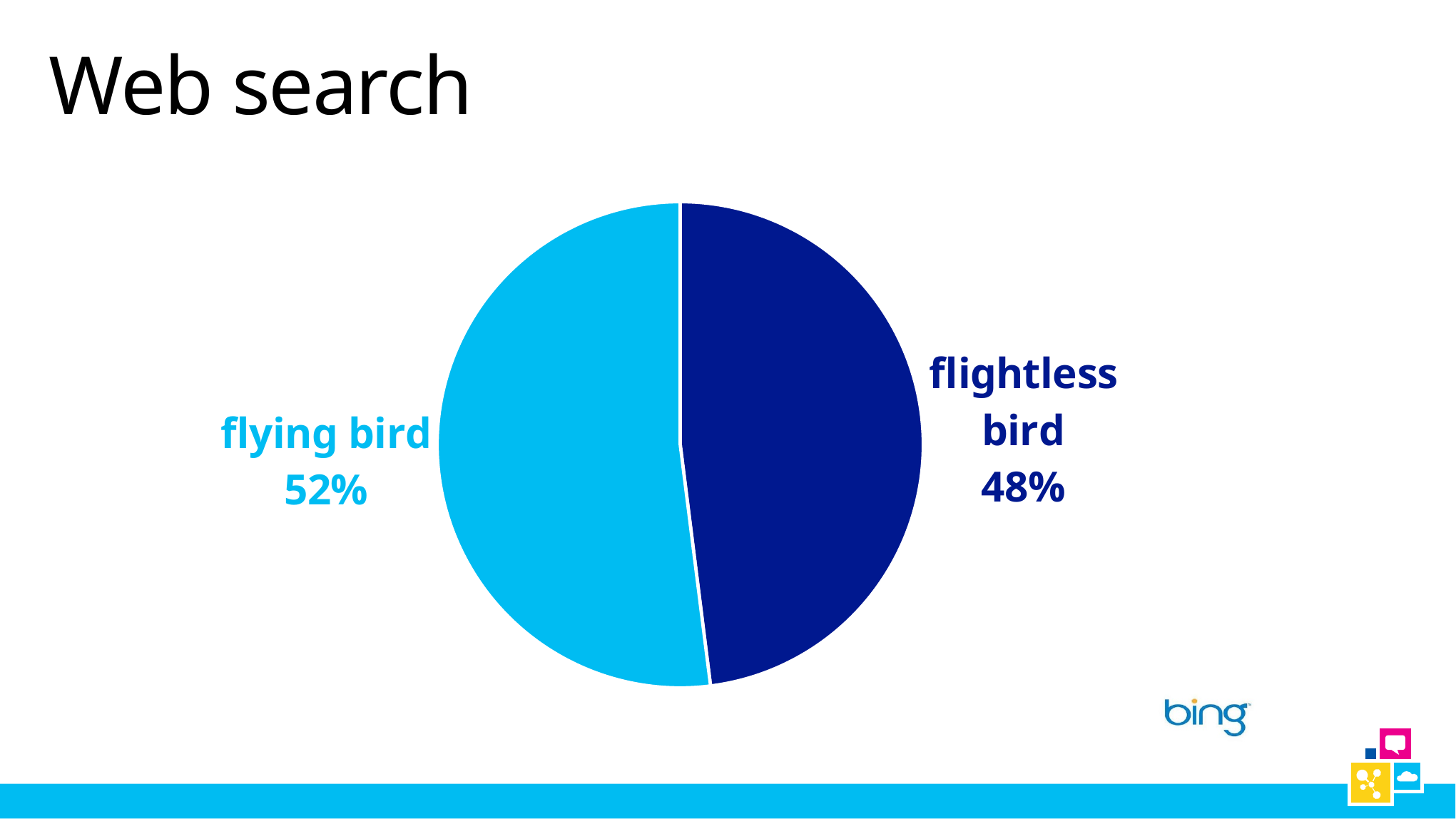
Which slice of the pie is the largest? flying bird What share of the pie does "flying bird" have? 52% What is the title of the slide containing the pie chart? Web search Which is larger, the "flying bird" slice or the "flightless bird" slice? flying bird Is the value for "flightless bird" greater or less than 50%? less What colour is the "flightless bird" slice? dark blue Which slice of the pie is the smallest? flightless bird What kind of chart is shown on the slide? pie chart What is the difference in percentage points between the "flying bird" and "flightless bird" slices? 4 What share of the pie does "flightless bird" have? 48% How many slices does the pie chart have? 2